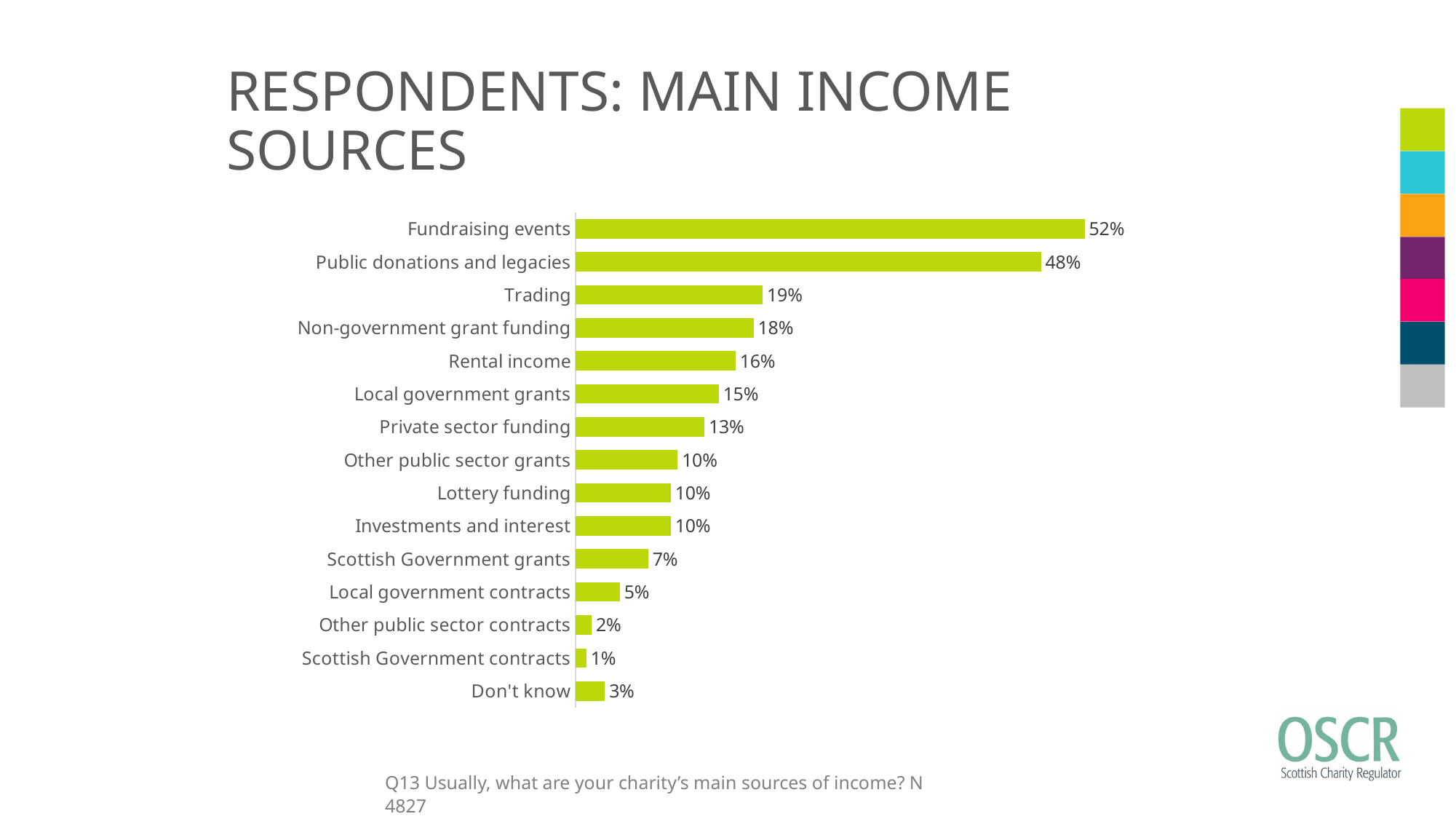
What is the value shown for Scottish Government contracts? 1% Which income source has the lowest percentage? Scottish Government contracts What is the difference between Fundraising events and Public donations and legacies? 4 percentage points Which is larger, Don't know or Other public sector contracts? Don't know What is the title of the slide? RESPONDENTS: MAIN INCOME SOURCES What is the difference between Trading and Local government contracts? 14 percentage points Which income source has the highest percentage? Fundraising events What type of chart is shown on the slide? Bar chart What is the value shown for Rental income? 16% Which is larger, Private sector funding or Scottish Government grants? Private sector funding How many income source categories are shown in the chart? 15 What percentage of respondents cited Fundraising events as a main income source? 52%